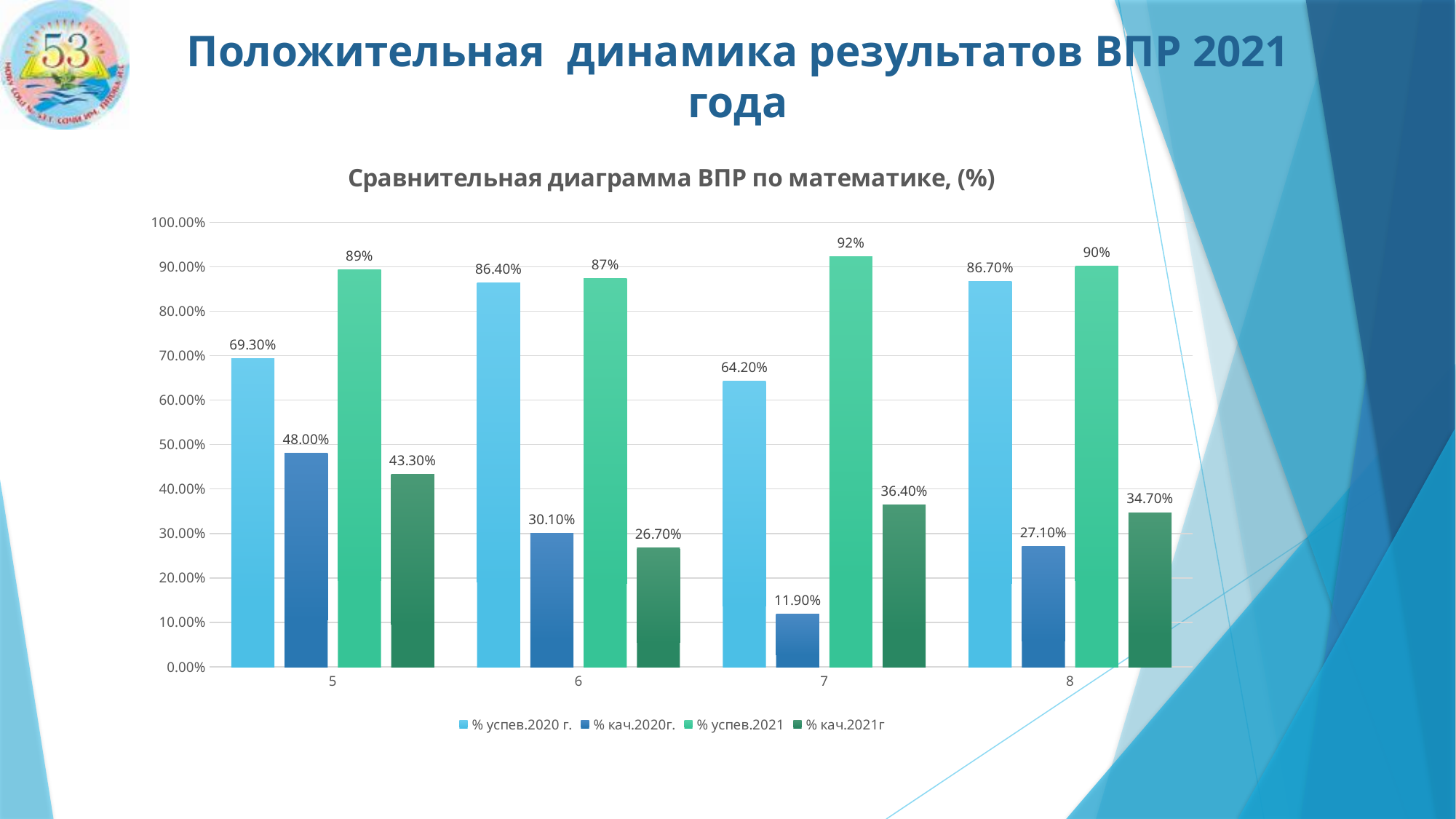
What is the title of the chart? Сравнительная диаграмма ВПР по математике, (%) What is the value of % кач.2020г. for category 6? 30.10% Which category has the highest value for % успев.2021? 7 What kind of chart is shown on the slide? Bar chart What is the difference between % кач.2021г and % кач.2020г. for category 7? 24.50% Which is larger for category 5: % кач.2020г. or % кач.2021г? % кач.2020г. What is the value of % успев.2021 for category 8? 90% How many categories are shown on the x axis? 4 How many series does the legend list? 4 What is the value of % успев.2020 г. for category 5? 69.30% Which category has the lowest value for % кач.2020г.? 7 What is the value of % кач.2021г for category 7? 36.40%